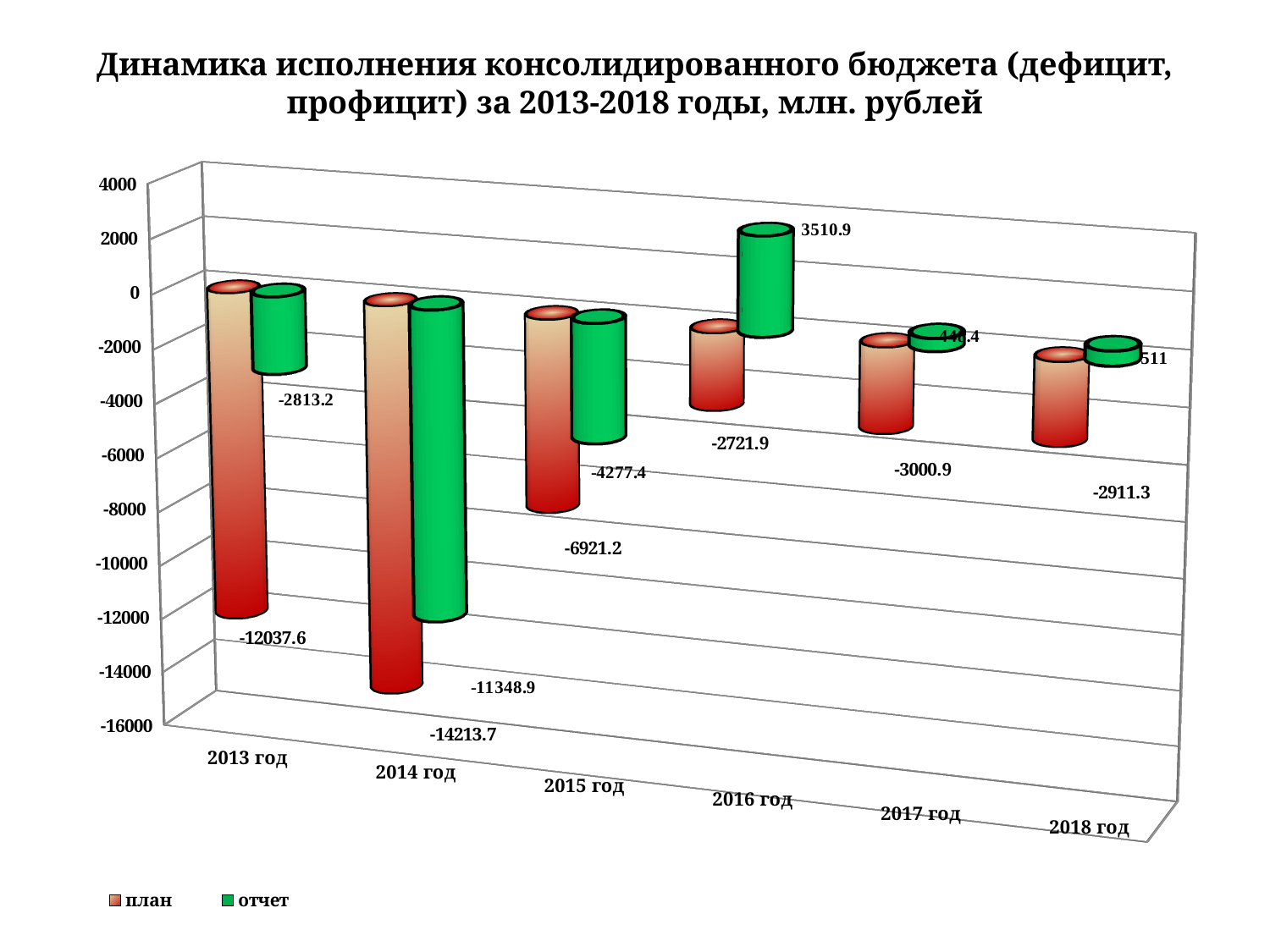
In which year is the отчет value the highest? 2016 год Is the отчет value for 2016 год greater or less than 2000? greater What is the план value for 2017 год? -3000.9 What is the отчет value for 2016 год? 3510.9 What is the difference between the отчет and план values for 2015 год? 2643.8 How many series does the legend list? 2 What kind of chart is shown on the slide? bar chart What is the отчет value for 2014 год? -11348.9 What is the план value for 2013 год? -12037.6 In which year is the план value the lowest? 2014 год How many years are shown on the x axis? 6 For 2013 год, which is higher: the план value or the отчет value? отчет